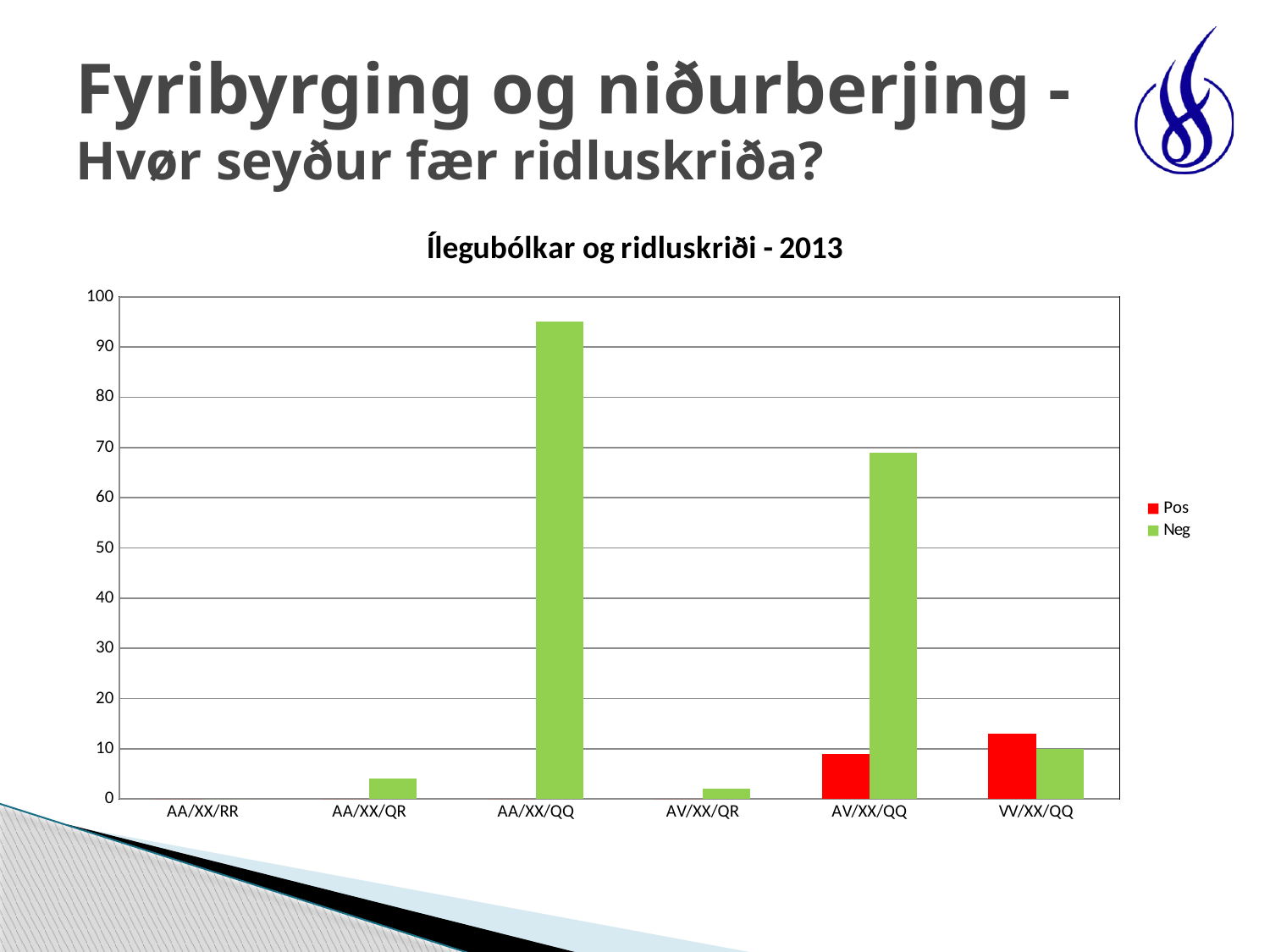
Which category has the highest Neg value? AA/XX/QQ How many series does the legend list? 2 Is the Neg value for AA/XX/QQ greater or less than 90? greater Is the Neg value for AA/XX/QR greater or less than 10? less Is the Pos value for VV/XX/QQ greater or less than 10? greater Which colour represents the Pos series in the legend? red How many categories are shown on the x axis? 6 What is the title of the chart? Ílegubólkar og ridluskriði - 2013 Which category has the highest Pos value? VV/XX/QQ Which is larger for AV/XX/QQ, the Pos value or the Neg value? Neg What kind of chart is shown on the slide? bar chart